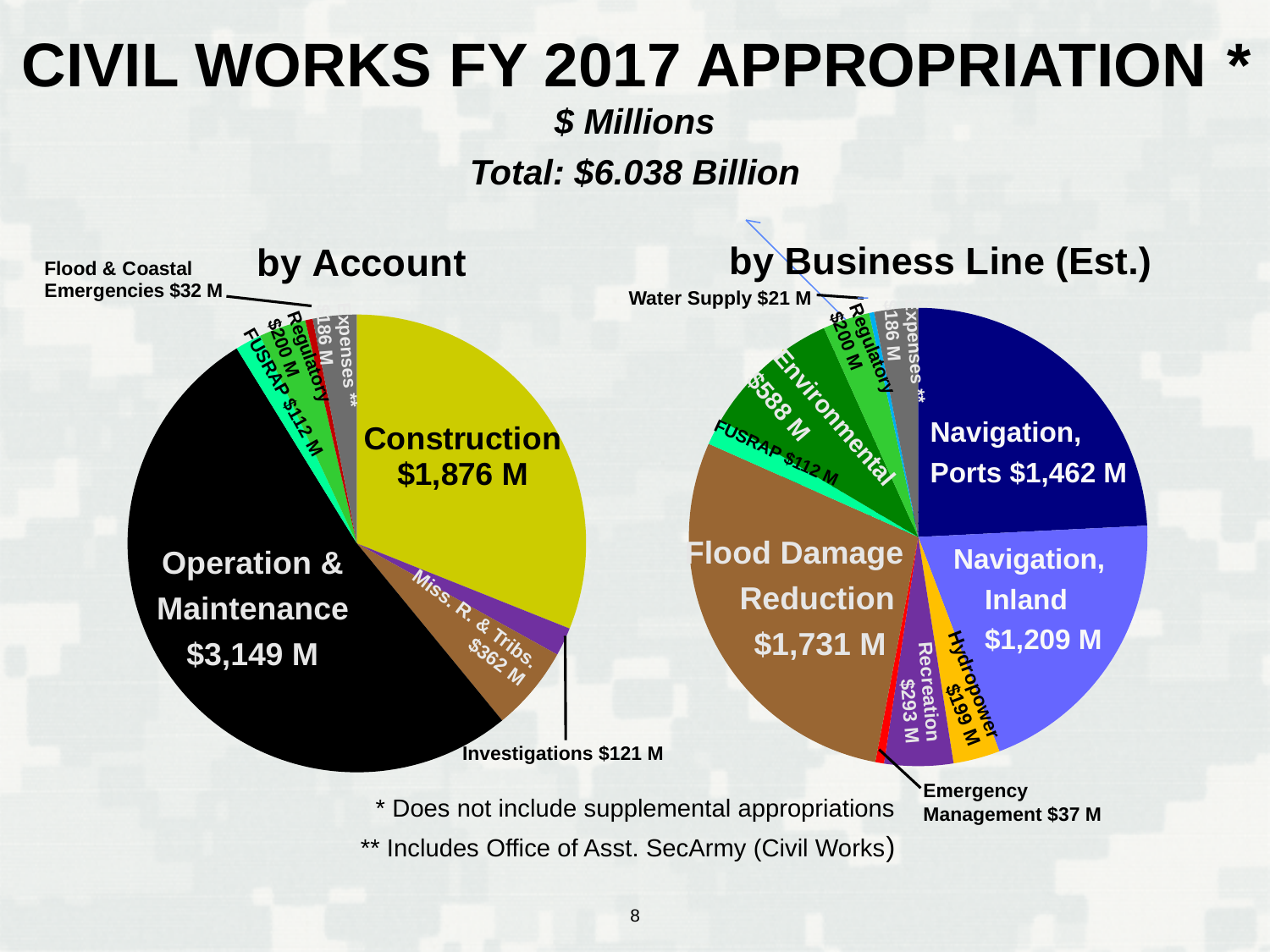
In the 'by Business Line (Est.)' pie chart, what is the value for Hydropower? $199 M What kind of charts are shown on the slide? Pie charts In the 'by Account' pie chart, what is the value for Investigations? $121 M In the 'by Business Line (Est.)' pie chart, what is the value for Flood Damage Reduction? $1,731 M In the 'by Business Line (Est.)' pie chart, what is the difference between Navigation, Ports and Navigation, Inland? $253 M In the 'by Account' pie chart, what is the value for Construction? $1,876 M In the 'by Business Line (Est.)' pie chart, which is larger, Navigation, Ports or Navigation, Inland? Navigation, Ports In the 'by Account' pie chart, what is the value for Operation & Maintenance? $3,149 M In the 'by Account' pie chart, which account has the smallest slice? Flood & Coastal Emergencies In the 'by Business Line (Est.)' pie chart, which business line has the smallest slice? Water Supply In the 'by Account' pie chart, which account has the largest slice? Operation & Maintenance In the 'by Account' pie chart, what is the difference between Operation & Maintenance and Construction? $1,273 M